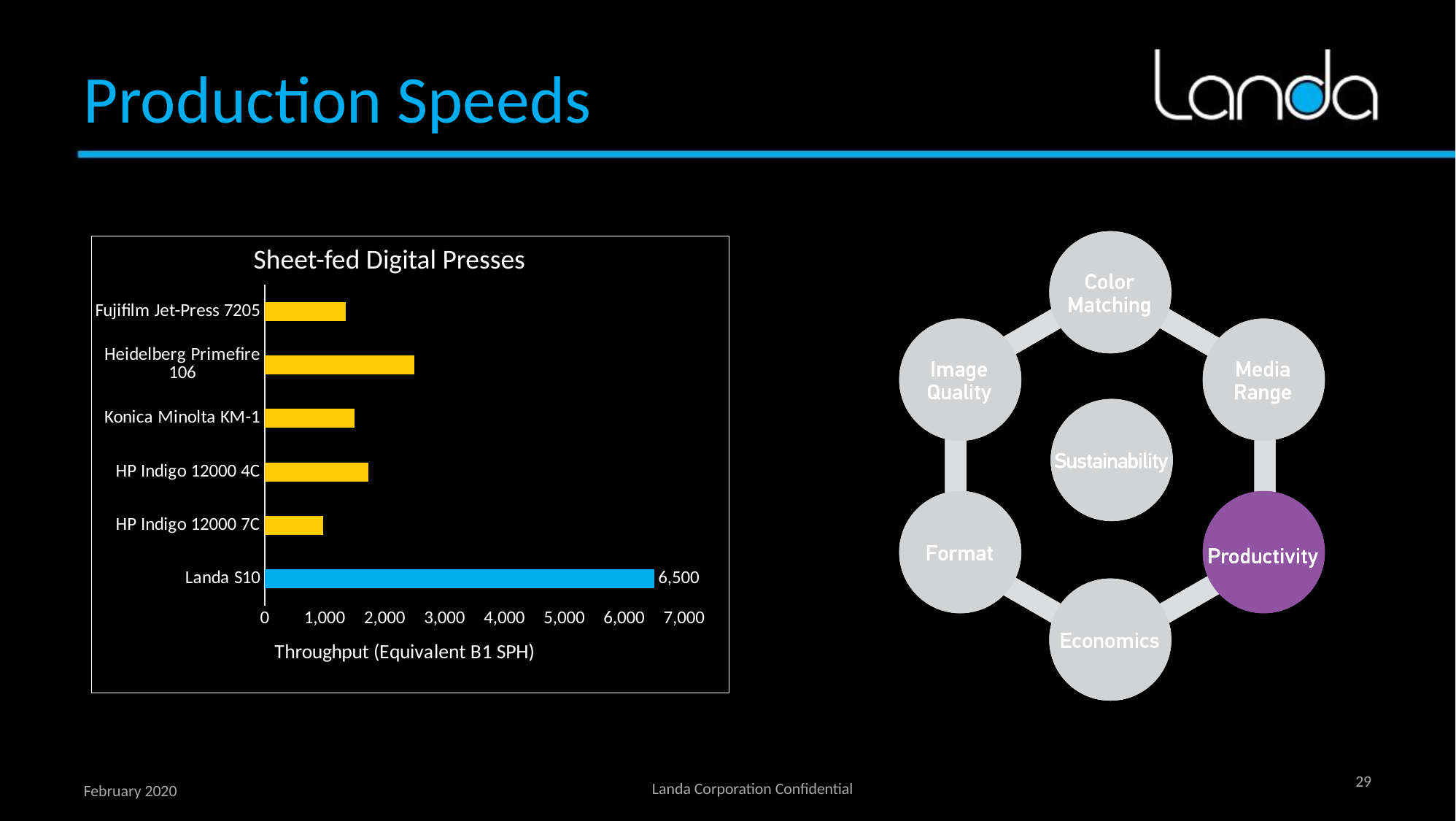
Is the value for Konica Minolta KM-1 greater or less than 1,000? greater Which press has the highest throughput in the chart? Landa S10 How many presses are shown in the chart? 6 What is the title of the chart's horizontal axis? Throughput (Equivalent B1 SPH) What kind of chart is used to show the production speeds? Bar chart What is the throughput value shown for Landa S10? 6,500 Which press has the lowest throughput in the chart? HP Indigo 12000 7C Which has a higher throughput, Heidelberg Primefire 106 or Konica Minolta KM-1? Heidelberg Primefire 106 Which has a higher throughput, Landa S10 or Heidelberg Primefire 106? Landa S10 Is the value for HP Indigo 12000 4C greater or less than 2,000? less Is the value for Fujifilm Jet-Press 7205 greater or less than 2,000? less